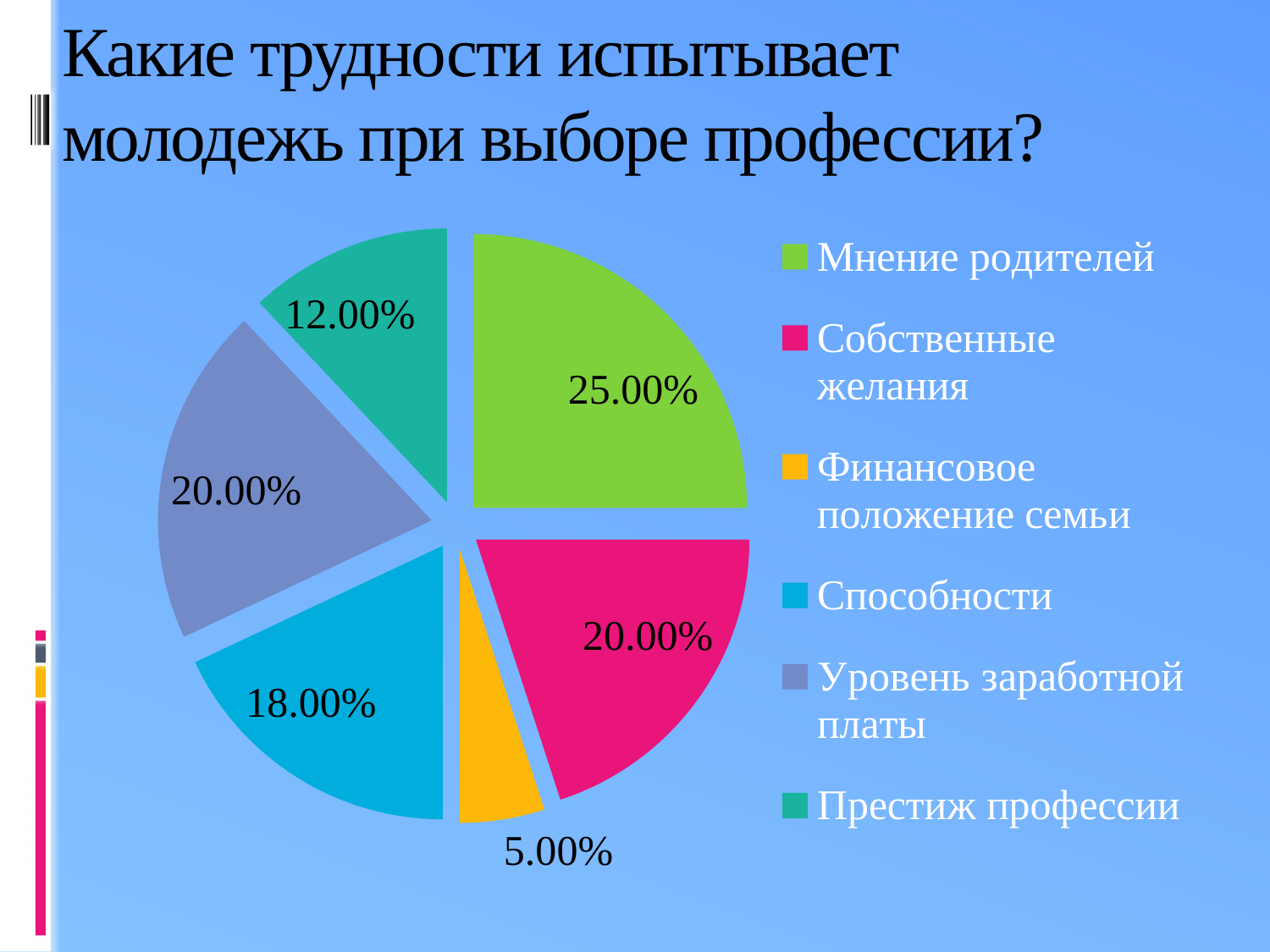
Which category has the smallest share of the pie? Финансовое положение семьи How many categories does the pie chart have? 6 Which is larger, the value for Способности or the value for Престиж профессии? Способности What is the value for Престиж профессии? 12.00% Which colour represents Собственные желания in the legend? pink Which category has the largest share of the pie? Мнение родителей What is the value for Финансовое положение семьи? 5.00% What kind of chart is shown on the slide? pie chart What is the value for Способности? 18.00% What is the value for Мнение родителей? 25.00% What is the difference between the values for Мнение родителей and Способности? 7.00% What is the title of the slide containing the chart? Какие трудности испытывает молодежь при выборе профессии?